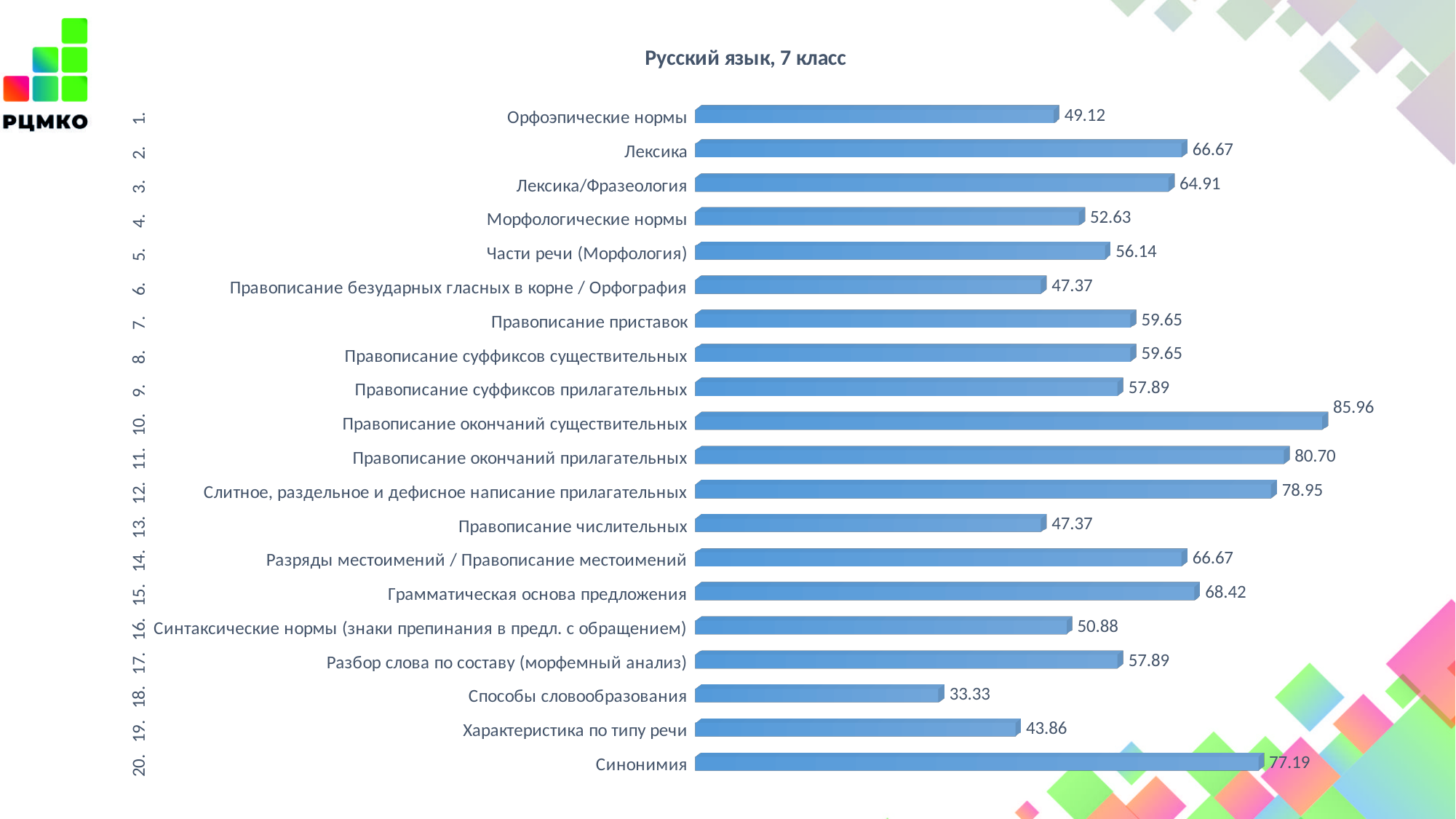
What is the value for Способы словообразования? 33.33 Which category has the lowest value? Способы словообразования What is the value for Грамматическая основа предложения? 68.42 What is the value for Орфоэпические нормы? 49.12 What kind of chart is shown on the slide? Bar chart What is the value for Синонимия? 77.19 What is the title of the chart? Русский язык, 7 класс What is the difference between the values for Правописание окончаний существительных and Способы словообразования? 52.63 Which category has the highest value? Правописание окончаний существительных Which is larger, the value for Правописание окончаний прилагательных or the value for Синонимия? Правописание окончаний прилагательных How many categories are shown in the chart? 20 What is the difference between the values for Лексика and Орфоэпические нормы? 17.55